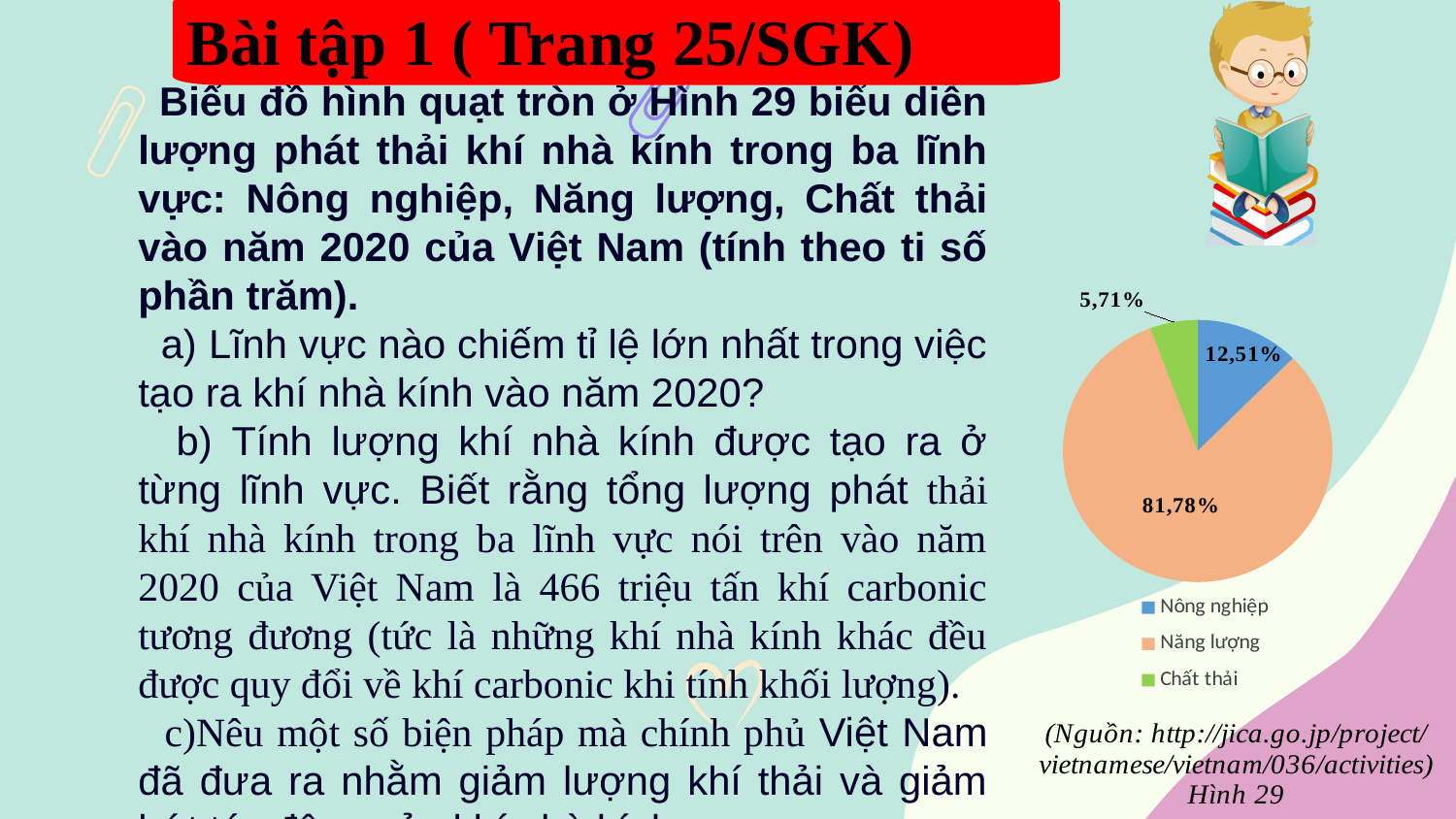
What kind of chart is shown on the slide? pie chart Which category has the largest share of the pie? Năng lượng What percentage does the Chất thải slice show? 5,71% What is the difference in percentage points between the Năng lượng slice and the Nông nghiệp slice? 69,27 Which category has the smallest share of the pie? Chất thải What is the difference in percentage points between the Nông nghiệp slice and the Chất thải slice? 6,80 Which colour represents Năng lượng in the pie chart? orange Which is larger, the share for Nông nghiệp or the share for Chất thải? Nông nghiệp How many entries does the legend list? 3 What percentage does the Nông nghiệp slice show? 12,51% How many slices does the pie chart have? 3 What percentage does the Năng lượng slice show? 81,78%